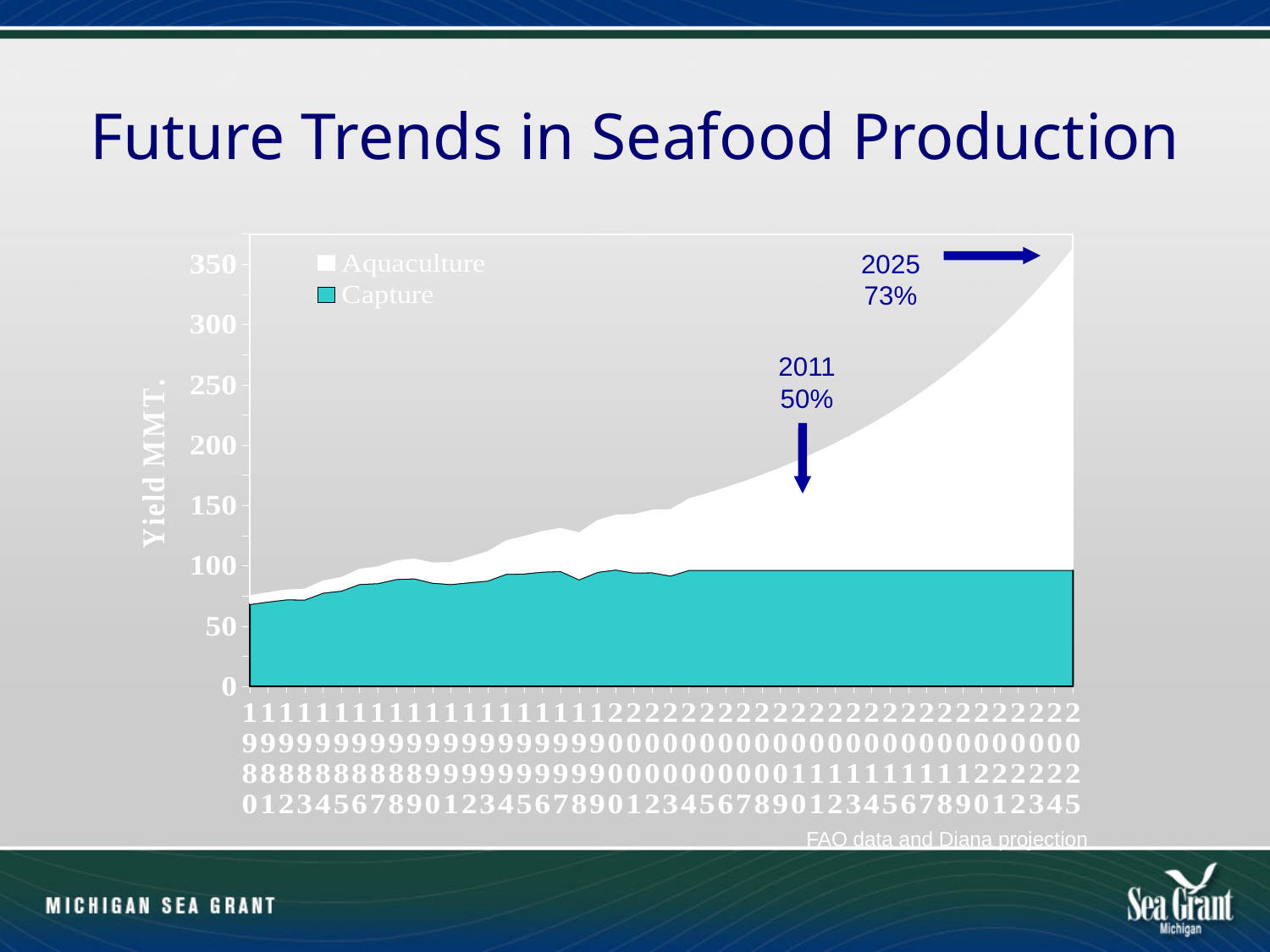
How many series does the chart's legend list? 2 According to the annotation on the chart, what share is marked for 2025? 73% What are the two series named in the chart's legend? Aquaculture and Capture In 1980, which series contributes more to the total yield, Aquaculture or Capture? Capture In 2025, which series contributes more to the total yield, Aquaculture or Capture? Aquaculture What kind of chart is shown on the slide? Stacked area chart Does the total seafood yield rise or fall from 1980 to 2025 along the x axis? Rise Is the total yield (Capture plus Aquaculture) in 2025 greater or less than 300 MMT? greater Is the total yield in 1980 greater or less than 100 MMT? less According to the annotation on the chart, what share is marked for 2011? 50% What is the label on the chart's y axis? Yield MMT.